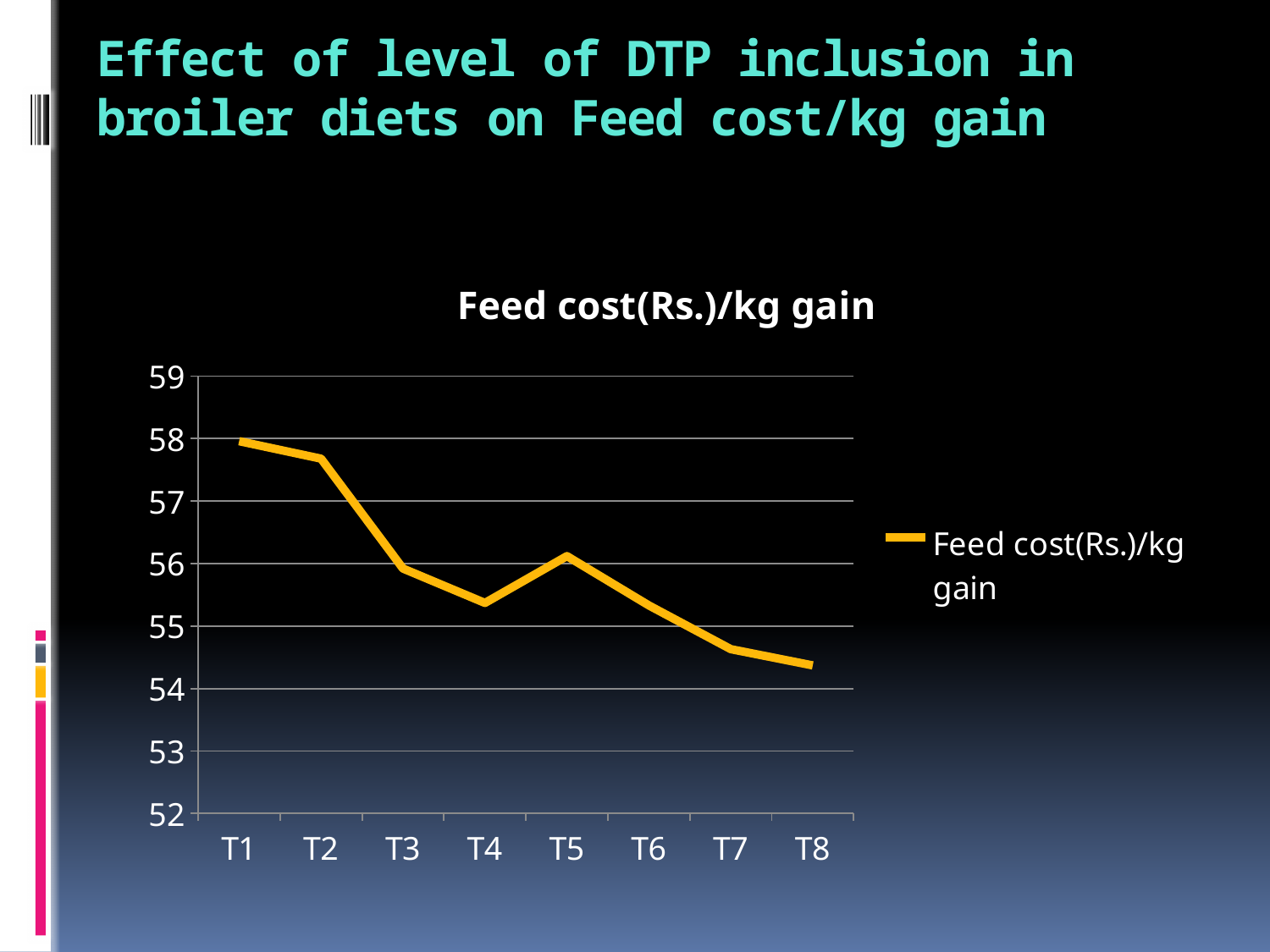
What kind of chart is shown on the slide? line chart Which category has the lowest feed cost per kg gain? T8 Which category has the highest feed cost per kg gain? T1 Is the value for T7 greater or less than 55? less Which has a higher feed cost per kg gain, T1 or T8? T1 How many series does the chart legend list? 1 Which has a higher feed cost per kg gain, T4 or T5? T5 Is the value for T1 greater or less than 57? greater Overall, do the values rise or fall from T1 to T8? fall How many categories are shown on the x axis of the chart? 8 What is the title of the chart? Feed cost(Rs.)/kg gain Is the value for T4 greater or less than 56? less